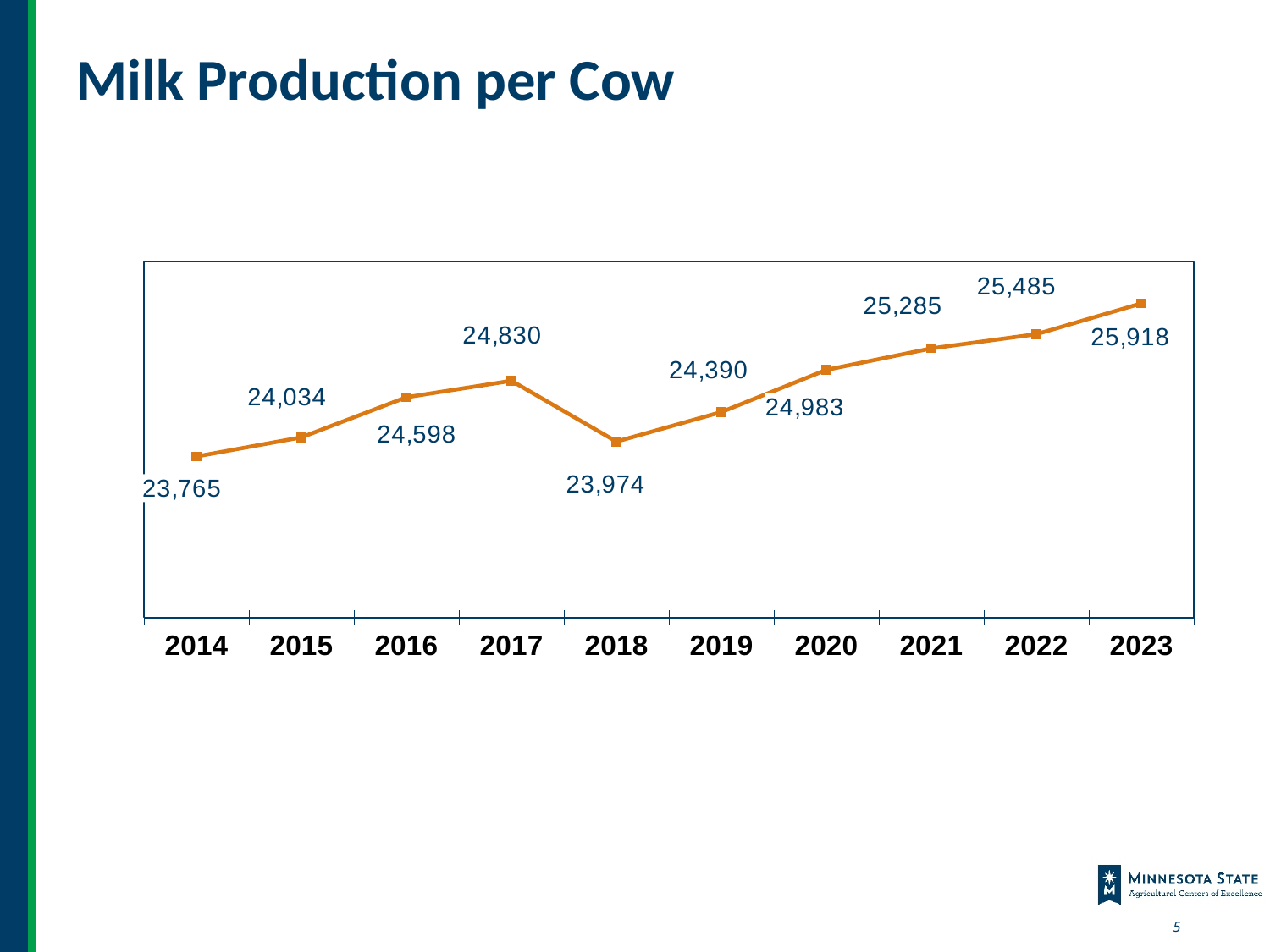
Which year has higher milk production per cow, 2017 or 2019? 2017 What kind of chart is shown on the slide? Line chart Which year has the lowest milk production per cow? 2014 What is the milk production per cow in 2018? 23,974 Which year has higher milk production per cow, 2016 or 2020? 2020 What is the difference in milk production per cow between 2023 and 2014? 2,153 Which year has the highest milk production per cow? 2023 What is the milk production per cow in 2023? 25,918 How many years are plotted on the chart? 10 By how much did milk production per cow fall from 2017 to 2018? 856 What is the title of the chart on the slide? Milk Production per Cow What is the milk production per cow in 2014? 23,765